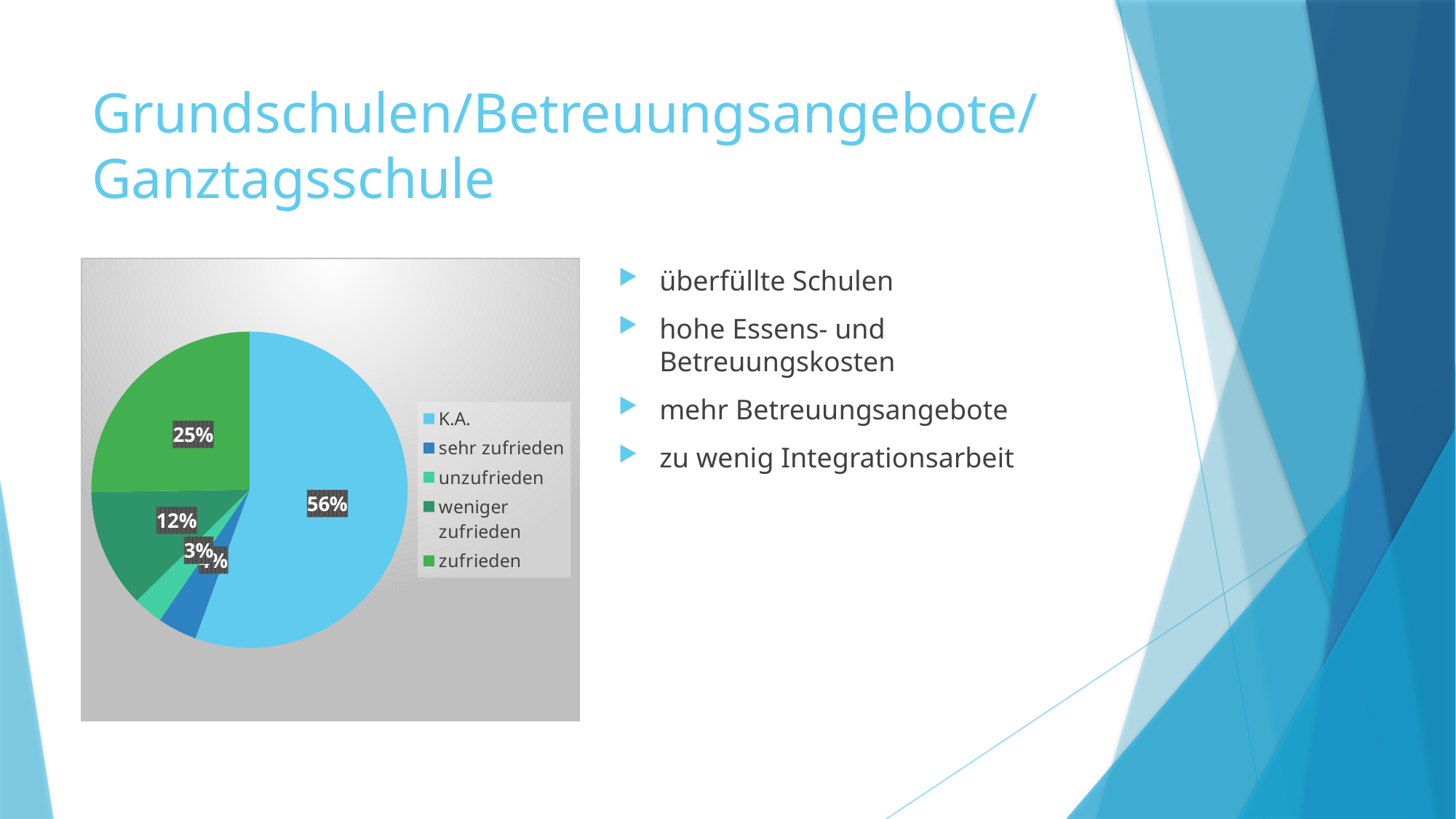
What percentage does the unzufrieden slice show? 3% What is the difference in percentage points between the K.A. slice and the zufrieden slice? 31 Which slice is larger, zufrieden or weniger zufrieden? zufrieden What percentage does the K.A. slice show? 56% What share of the pie does the K.A. slice represent? 56% How many categories does the legend of the pie chart list? 5 What is the difference in percentage points between the zufrieden slice and the weniger zufrieden slice? 13 What colour is the K.A. slice in the pie chart? light blue What percentage does the weniger zufrieden slice show? 12% Which category has the largest slice of the pie? K.A. What percentage does the zufrieden slice show? 25% What kind of chart is shown on the slide? pie chart